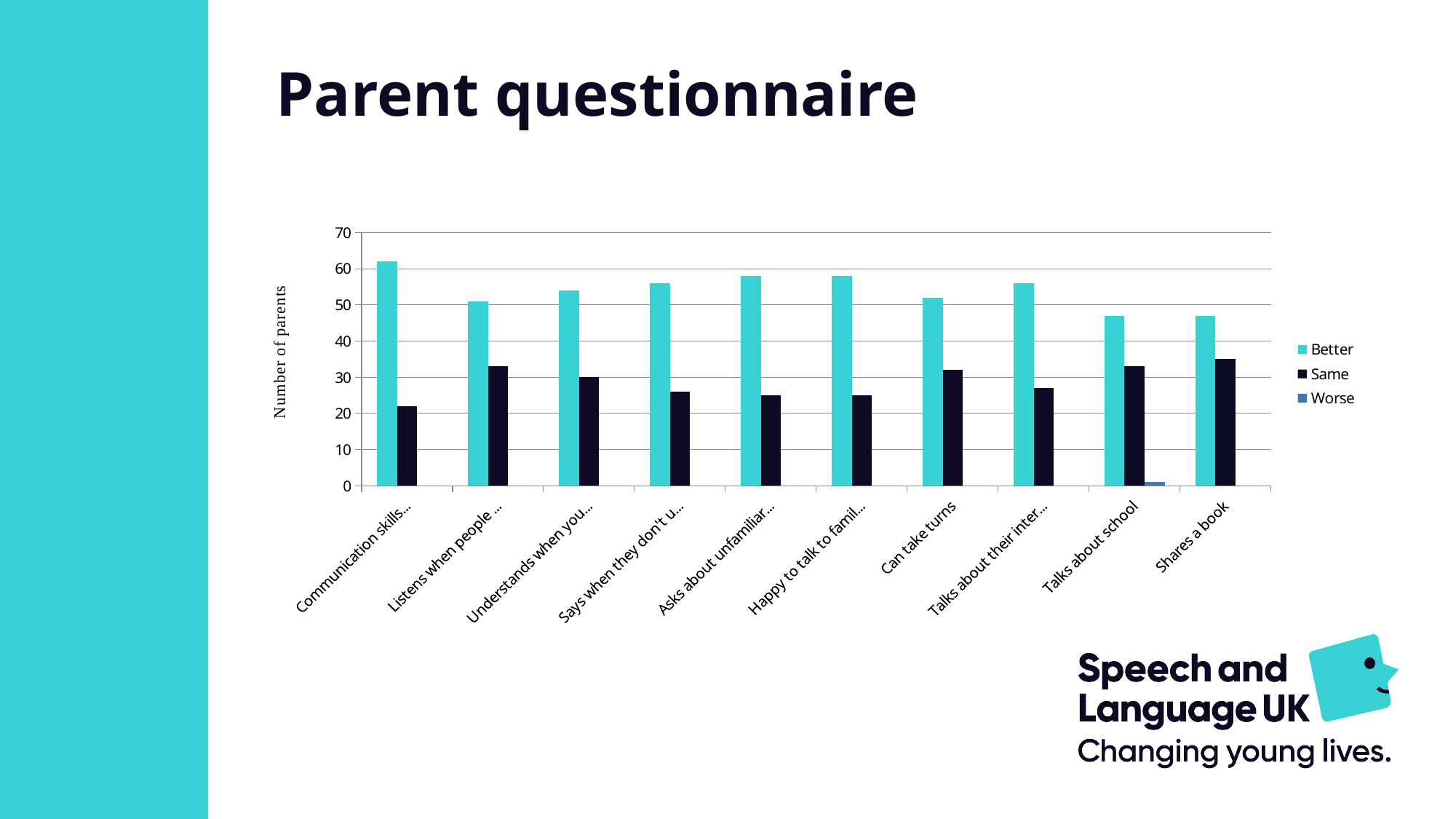
Is the Same value for Communication skills greater or less than 30? less What are the three entries in the legend? Better, Same, Worse Which category has the lowest value for the Same series? Communication skills What kind of chart is shown on the slide? bar chart What is the label on the vertical axis? Number of parents Which category has the highest value for the Better series? Communication skills How many series does the legend list? 3 Which category is the only one with a visible Worse bar? Talks about school Is the Better value for Shares a book greater or less than 50? less Is the Same value for Shares a book greater or less than 30? greater For Shares a book, which is larger: the Better value or the Same value? Better How many categories are shown along the x axis? 10